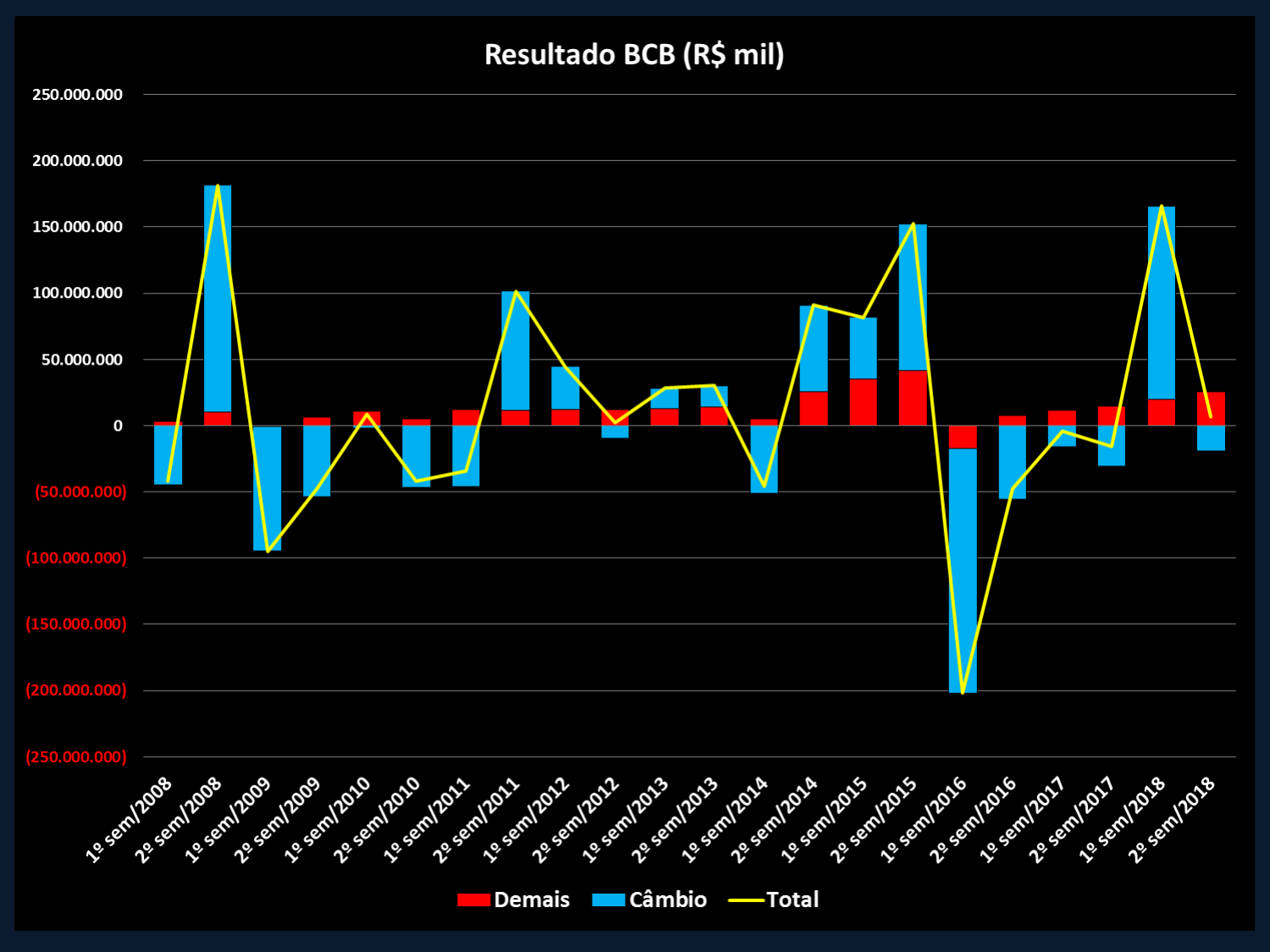
In which semester is the Total line at its highest? 2º sem/2008 Which semester has the larger Total value, 2º sem/2015 or 2º sem/2014? 2º sem/2015 Is the Total value for 1º sem/2009 greater or less than (50.000.000)? less In which semester is the Total line at its lowest? 1º sem/2016 What kind of chart is shown on the slide? A bar chart with a line How many series does the legend list? 3 Is the Câmbio value for 2º sem/2008 greater or less than 150.000.000? greater How many semester categories are shown on the x axis? 22 Which series is drawn as a yellow line? Total What is the title of the chart? Resultado BCB (R$ mil) Is the Total value for 1º sem/2016 greater or less than (150.000.000)? less